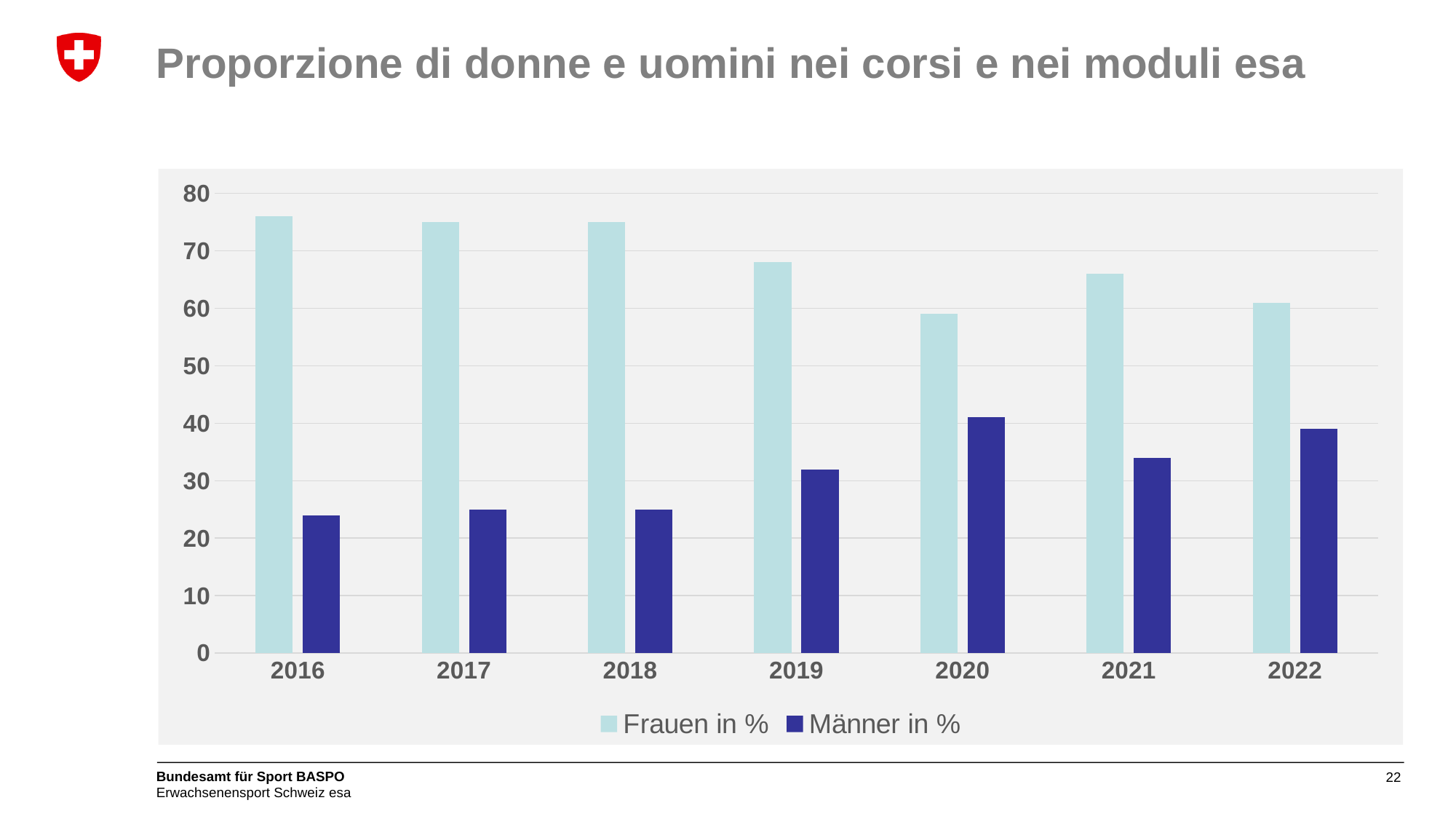
How many years are shown on the x axis of the chart? 7 Is the value for Frauen in % in 2016 greater or less than 70? greater What is the title of the slide containing the chart? Proporzione di donne e uomini nei corsi e nei moduli esa Which is larger in 2016, Frauen in % or Männer in %? Frauen in % What are the two series named in the legend? Frauen in % and Männer in % How many series does the chart's legend list? 2 Is the value for Männer in % in 2020 greater or less than 30? greater What kind of chart is shown on the slide? bar chart Does the Männer in % series generally rise or fall from 2016 to 2022? rise Is the value for Frauen in % in 2022 greater or less than 70? less Which is larger for Männer in %, 2020 or 2021? 2020